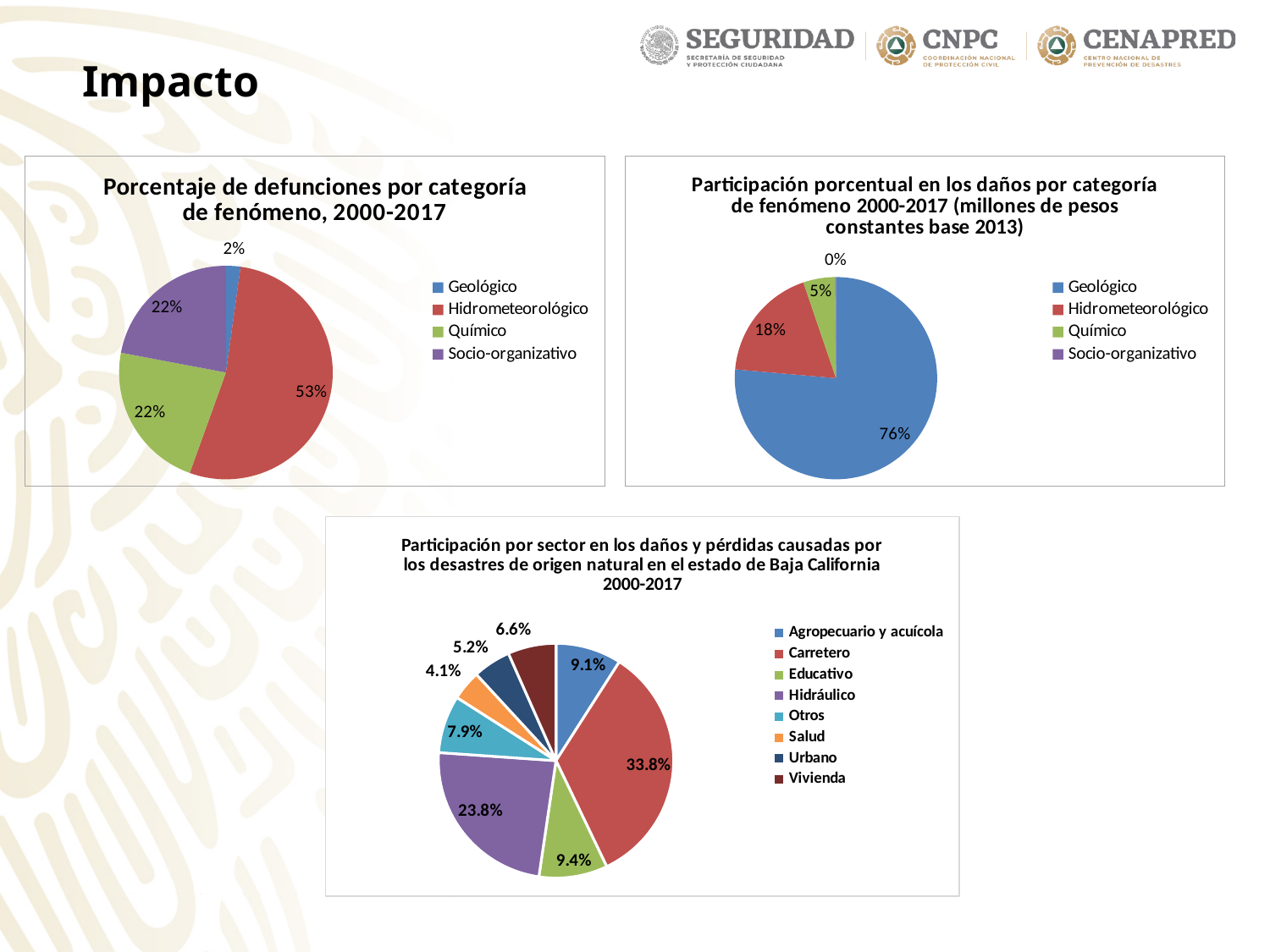
In the chart titled 'Porcentaje de defunciones por categoría de fenómeno, 2000-2017', which category has the smallest share? Geológico In the chart titled 'Participación porcentual en los daños por categoría de fenómeno 2000-2017', what share does Socio-organizativo have? 0% In the chart titled 'Porcentaje de defunciones por categoría de fenómeno, 2000-2017', what share does Hidrometeorológico have? 53% What type of chart is the bottom chart about Baja California? Pie chart In the bottom chart about Baja California, what share does Carretero have? 33.8% In the bottom chart about Baja California, which is larger, Hidráulico or Educativo? Hidráulico In the bottom chart about Baja California, which sector has the smallest share? Salud In the chart titled 'Porcentaje de defunciones por categoría de fenómeno, 2000-2017', what is the difference between the Hidrometeorológico share and the Socio-organizativo share? 31% In the chart titled 'Participación porcentual en los daños por categoría de fenómeno 2000-2017', how many categories does the legend list? 4 In the chart titled 'Participación porcentual en los daños por categoría de fenómeno 2000-2017', what share does Geológico have? 76% In the chart titled 'Participación porcentual en los daños por categoría de fenómeno 2000-2017', which category has the largest share? Geológico In the bottom chart about Baja California, how many sectors does the legend list? 8